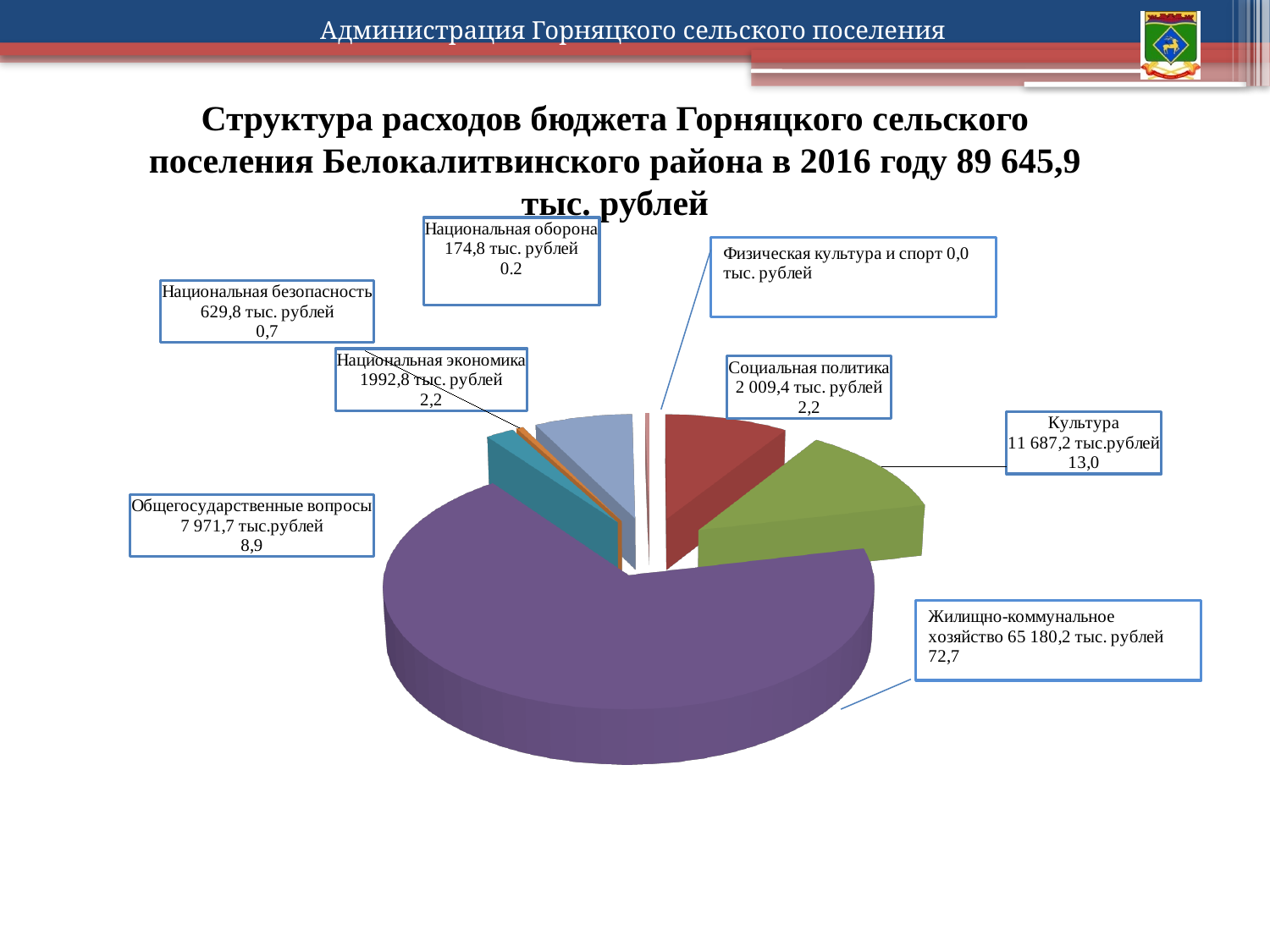
What share of the pie does Общегосударственные вопросы represent? 8,9 What share of the pie does Жилищно-коммунальное хозяйство represent? 72,7 Which category has the largest share of the pie? Жилищно-коммунальное хозяйство What is the difference between the values for Культура and Общегосударственные вопросы? 3 715,5 тыс. рублей How many expenditure categories are labelled on the pie chart? 8 What is the value for Культура? 11 687,2 тыс.рублей Which is larger, the value for Социальная политика or the value for Национальная оборона? Социальная политика What type of chart is shown on the slide? Pie chart What total budget expenditure is stated in the chart title? 89 645,9 тыс. рублей What is the value for Жилищно-коммунальное хозяйство? 65 180,2 тыс. рублей Which category has the smallest value? Физическая культура и спорт What is the value for Национальная безопасность? 629,8 тыс. рублей